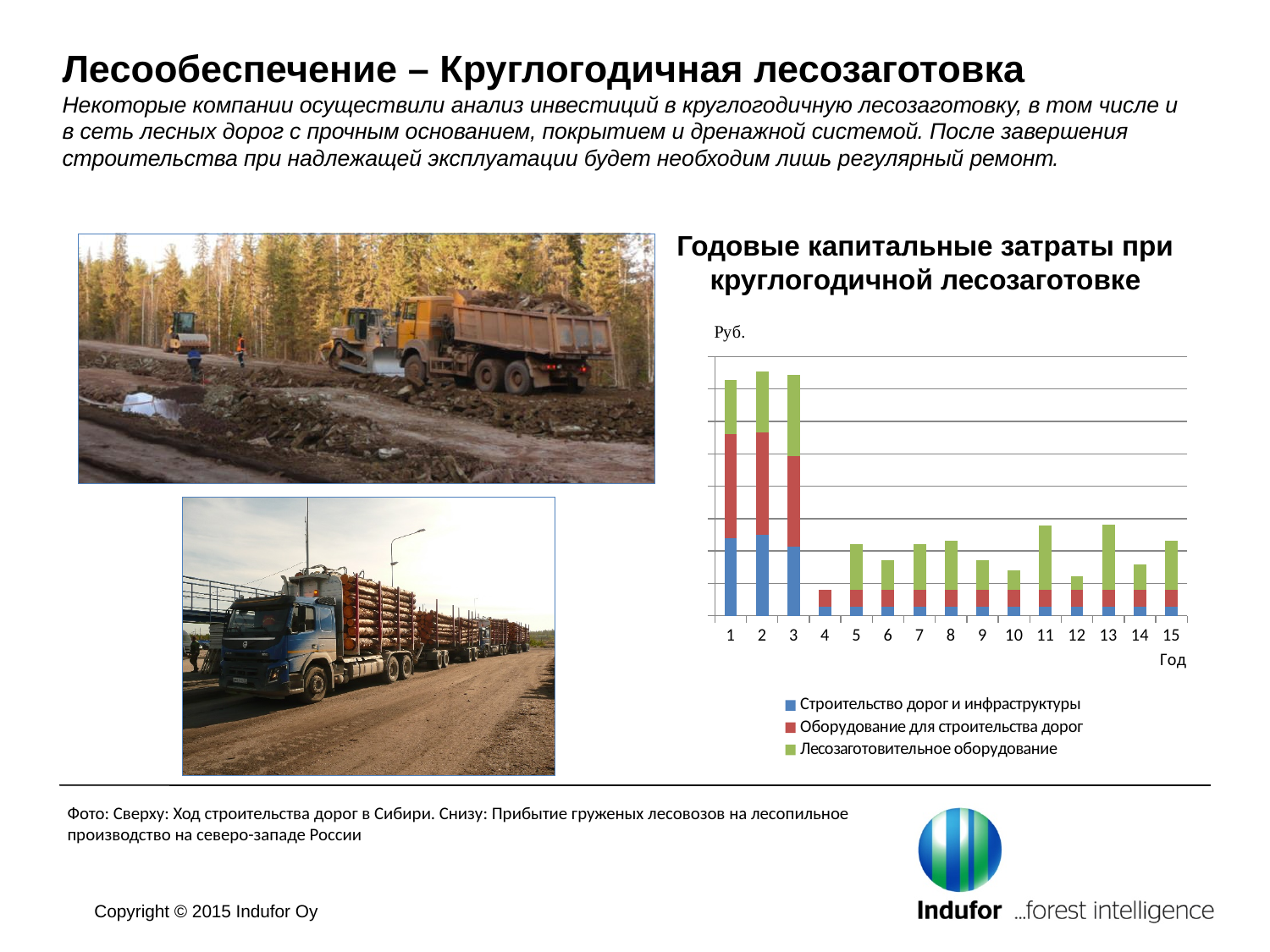
Do the total bars rise or fall from year 1 to year 4? Fall What is the title of the chart? Годовые капитальные затраты при круглогодичной лесозаготовке What kind of chart is shown on the slide? Stacked bar chart Which year has a larger total bar, year 11 or year 12? 11 How many series does the chart legend list? 3 Which year has a larger 'Строительство дорог и инфраструктуры' segment, year 2 or year 5? 2 Which series is shown in green in the chart? Лесозаготовительное оборудование Which year has the lowest total annual capital cost in the chart? 4 How many years (categories) are plotted on the x axis of the chart? 15 Which year has a larger total bar, year 1 or year 4? 1